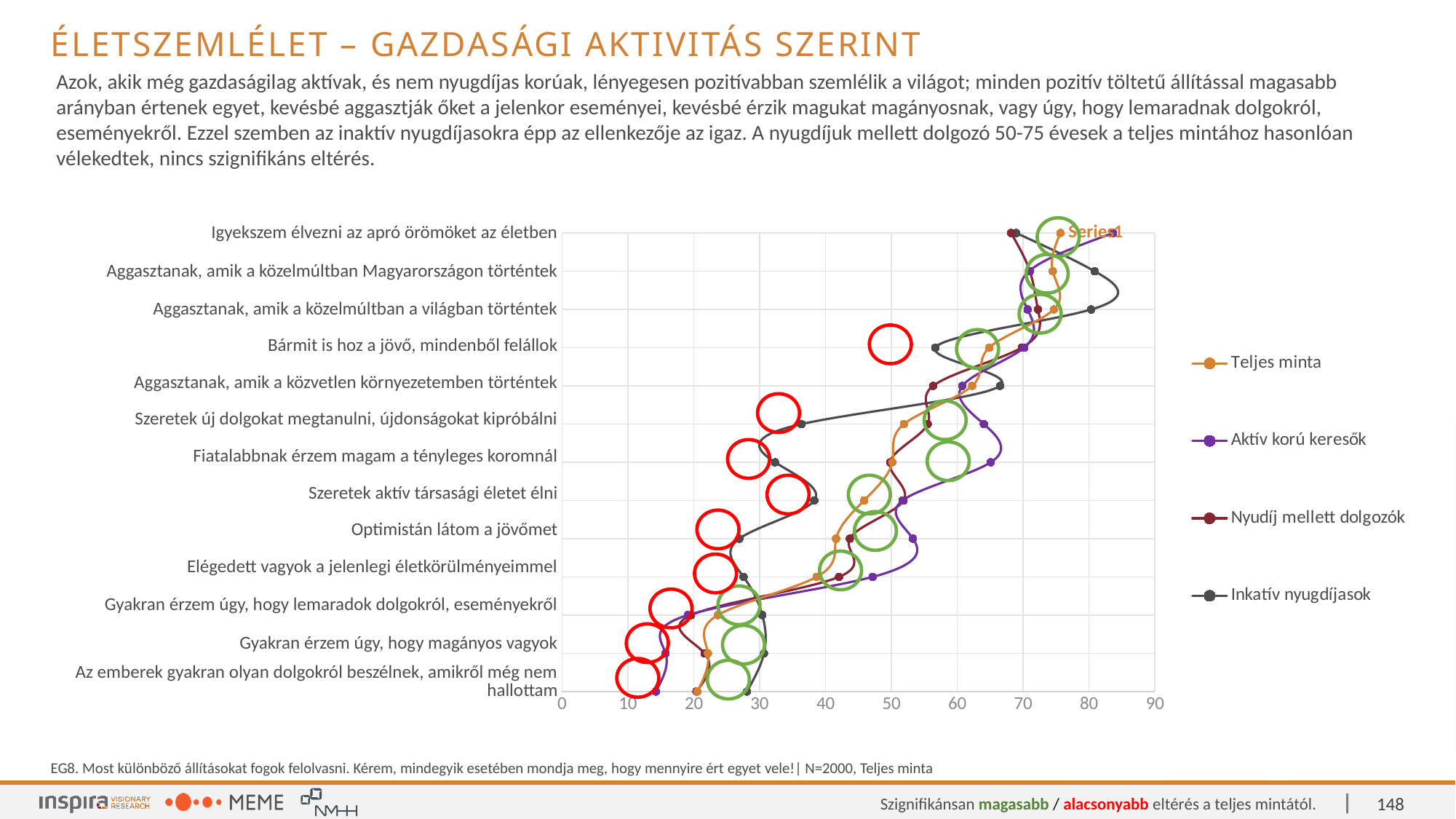
Is the value for Aktív korú keresők on 'Fiatalabbnak érzem magam a tényleges koromnál' greater or less than 60? greater Is the value for Aktív korú keresők on 'Gyakran érzem úgy, hogy magányos vagyok' greater or less than 20? less How many series does the legend list? 4 What kind of chart is shown on the slide? line chart For 'Fiatalabbnak érzem magam a tényleges koromnál', which is larger: Aktív korú keresők or Inkatív nyugdíjasok? Aktív korú keresők How many statements (categories) are plotted on the vertical axis? 13 Is the value for Inkatív nyugdíjasok on 'Optimistán látom a jövőmet' greater or less than 30? less For the Inkatív nyugdíjasok series, which statement has the highest value? Aggasztanak, amik a közelmúltban Magyarországon történtek For 'Szeretek új dolgokat megtanulni, újdonságokat kipróbálni', which series has the lowest value? Inkatív nyugdíjasok What colour is the Teljes minta series in the legend? orange